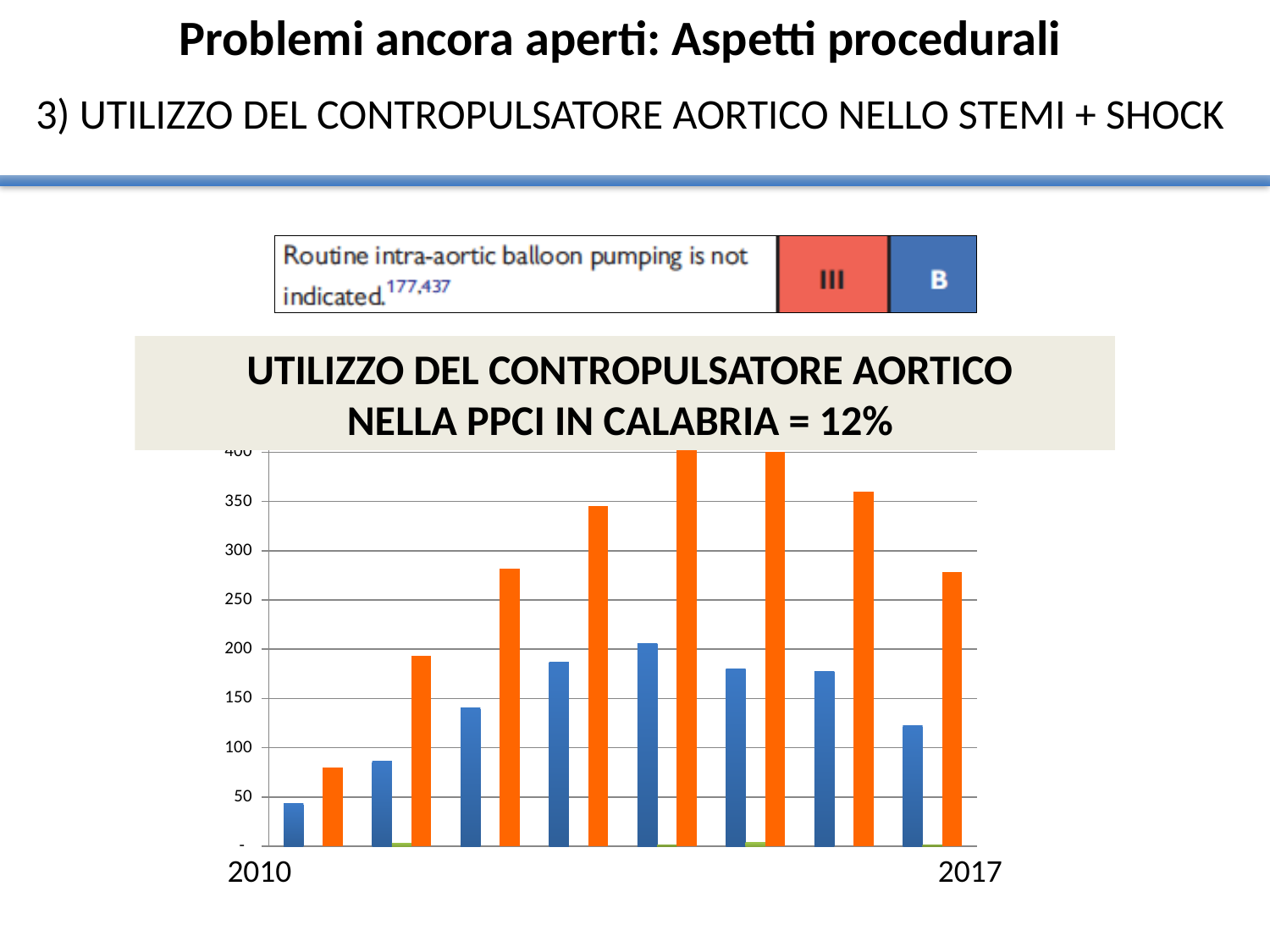
Is the value of the blue bar for 2010 greater or less than 50? less What is the title shown above the chart? UTILIZZO DEL CONTROPULSATORE AORTICO NELLA PPCI IN CALABRIA = 12% Which is taller, the blue bar for 2010 or the blue bar for 2017? 2017 How many year groups of bars are plotted along the x axis from 2010 to 2017? 8 What kind of chart is shown on the slide? bar chart Comparing 2010 with 2017, do the orange bars rise or fall overall? rise Is the value of the blue bar for 2017 greater or less than 100? greater Is the value of the orange bar for 2010 greater or less than 100? less For 2017, which bar is taller, the blue one or the orange one? orange Which year has the shortest blue bar? 2010 Which year has the shortest orange bar? 2010